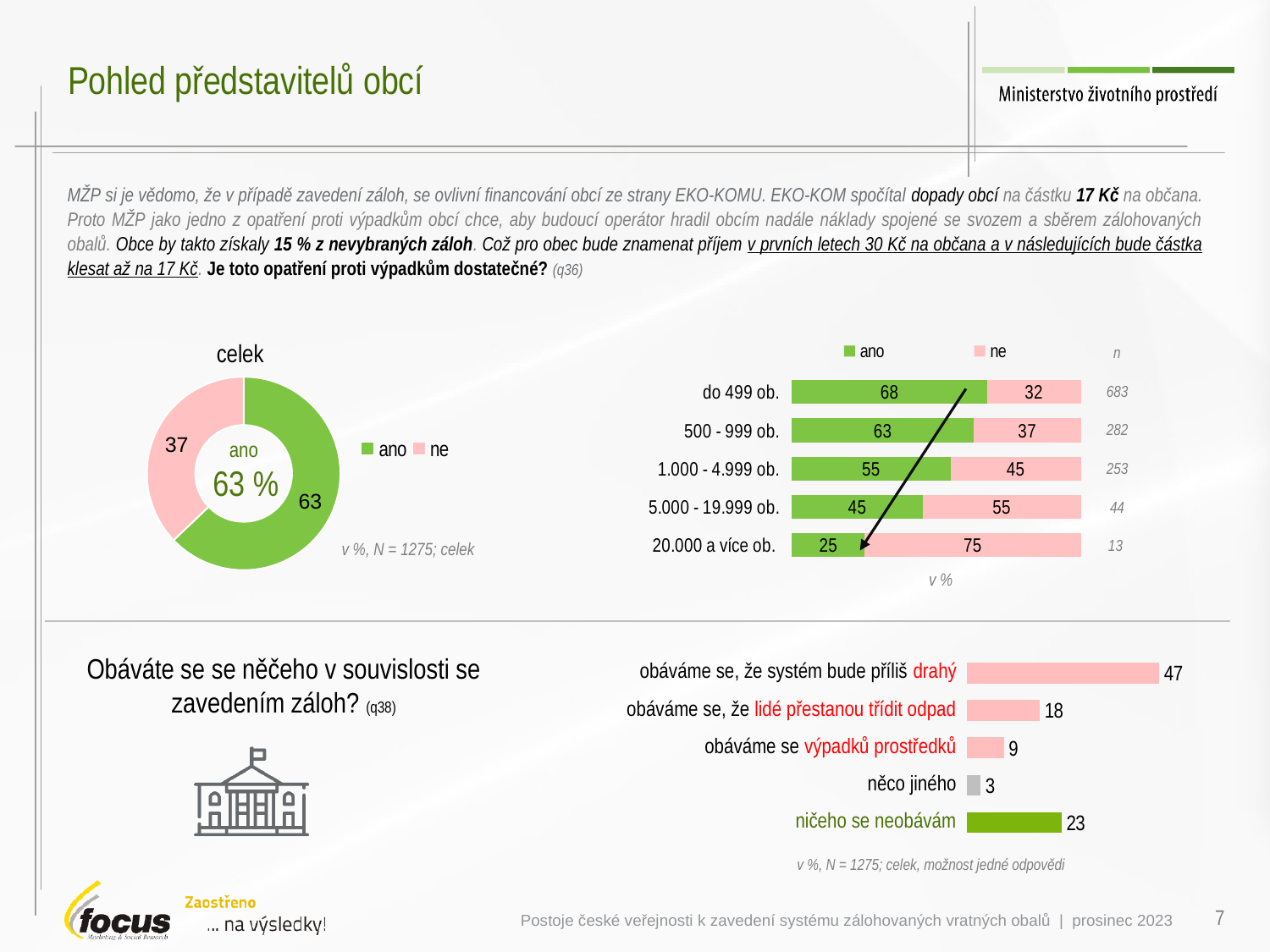
In the 'celek' donut chart, what percentage answered 'ano'? 63 What kind of chart is the 'celek' chart on the left of the slide? Donut (pie) chart In the stacked bar chart by municipality size, how does the 'ano' share change as municipality size increases from 'do 499 ob.' to '20.000 a více ob.'? It falls In the bottom bar chart about concerns (q38), which category has the lowest value? něco jiného In the 'celek' donut chart, what percentage answered 'ne'? 37 In the stacked bar chart by municipality size, which category has the lowest 'ano' value? 20.000 a více ob. How many series does the legend of the stacked bar chart by municipality size list? 2 In the stacked bar chart by municipality size, what is the 'ano' value for 'do 499 ob.'? 68 In the stacked bar chart by municipality size, what is the 'ne' value for '5.000 - 19.999 ob.'? 55 In the bottom bar chart about concerns (q38), what is the value for 'obáváme se, že systém bude příliš drahý'? 47 In the bottom bar chart about concerns (q38), how many categories are shown? 5 In the stacked bar chart by municipality size, what is the difference between the 'ano' values for 'do 499 ob.' and '500 - 999 ob.'? 5